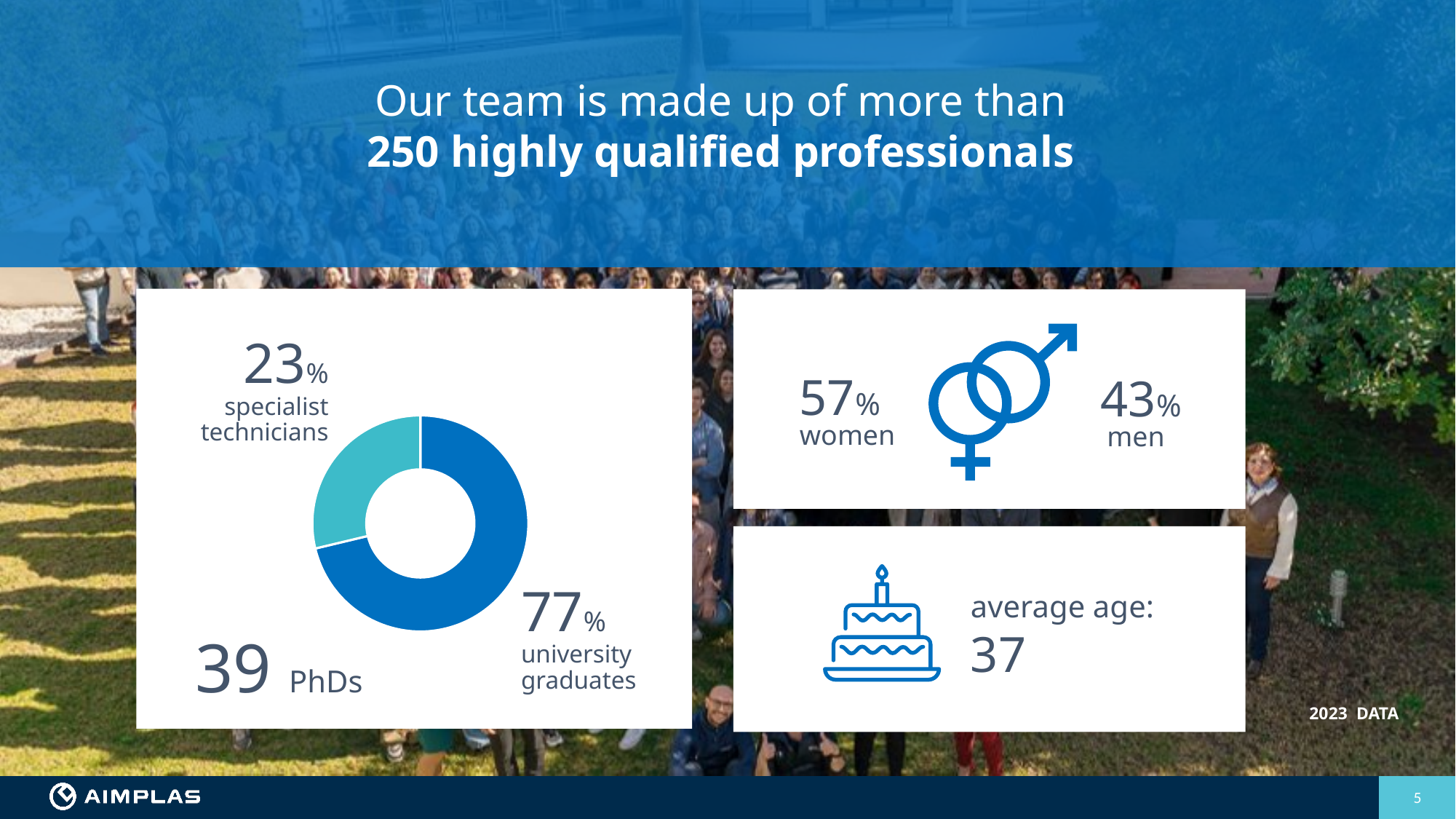
How many slices does the donut chart have? 2 What colour is the university graduates slice of the donut chart? Dark blue Which slice of the donut chart is the smallest? specialist technicians What share of the team are specialist technicians according to the donut chart? 23% What colour is the specialist technicians slice of the donut chart? Teal (light blue-green) What is the difference in percentage points between university graduates and specialist technicians in the donut chart? 54 What share of the team are university graduates according to the donut chart? 77% Is the share of specialist technicians in the donut chart greater or less than 50%? less Which is larger in the donut chart: the share of university graduates or the share of specialist technicians? university graduates What kind of chart is shown on the slide? Donut (pie) chart What do the two slices of the donut chart add up to? 100% Which slice of the donut chart is the largest? university graduates